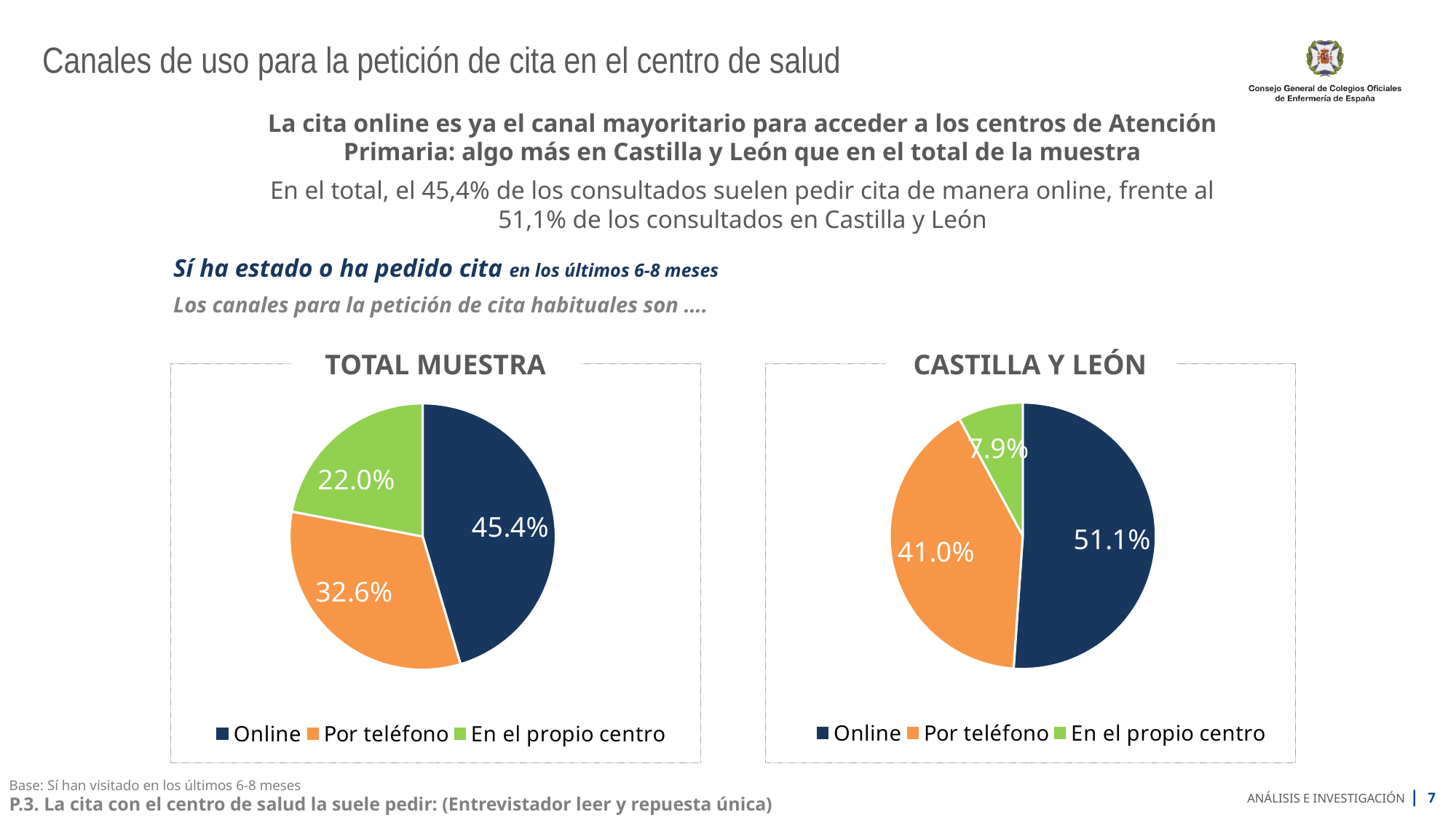
What is the difference between the Online values in the CASTILLA Y LEÓN chart and the TOTAL MUESTRA chart? 5.7% In the CASTILLA Y LEÓN chart, what is the value for En el propio centro? 7.9% In the CASTILLA Y LEÓN chart, which category has the smallest share? En el propio centro In the TOTAL MUESTRA chart, which colour represents En el propio centro? Green In the TOTAL MUESTRA chart, what is the value for Online? 45.4% In the TOTAL MUESTRA chart, what is the difference between Por teléfono and En el propio centro? 10.6% In the TOTAL MUESTRA chart, what is the value for Por teléfono? 32.6% In the CASTILLA Y LEÓN chart, what is the value for Por teléfono? 41.0% Which is larger: Por teléfono in the TOTAL MUESTRA chart or Por teléfono in the CASTILLA Y LEÓN chart? CASTILLA Y LEÓN What type of chart is the TOTAL MUESTRA chart? Pie chart How many slices does the CASTILLA Y LEÓN pie chart have? 3 In the TOTAL MUESTRA chart, which category has the largest share? Online